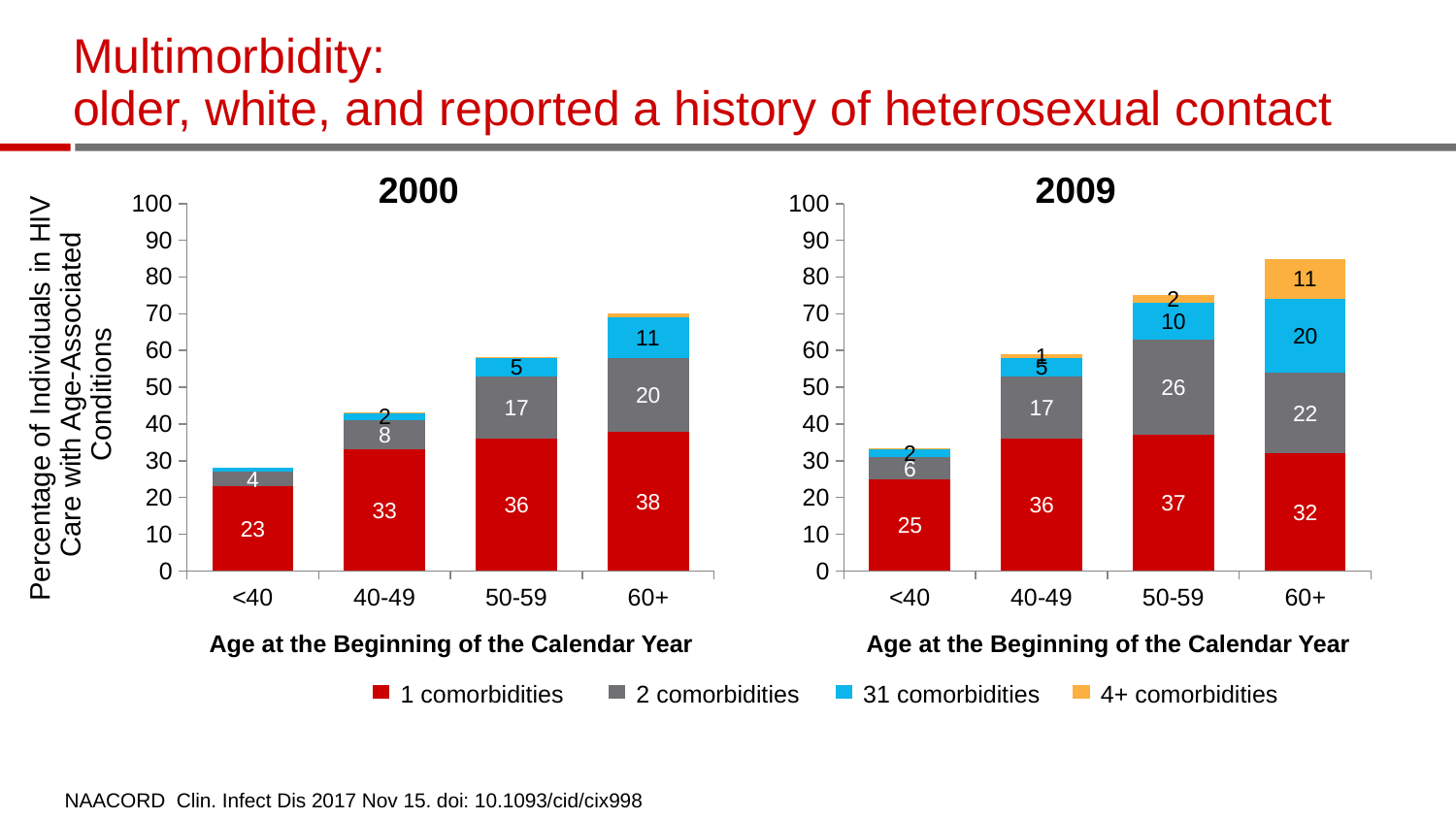
In the 2009 chart, what is the difference between the 2 comorbidities values for the 50-59 and 40-49 age groups? 9 In the 2009 chart, is the total height of the <40 bar greater or less than 30? greater In the 2000 chart, which age group has the highest value for 1 comorbidities? 60+ What kind of chart is the 2009 chart? Stacked bar chart In the 2009 chart, what is the value for 4+ comorbidities in the 60+ age group? 11 How many series does the legend list? 4 For the 60+ age group, is the 1 comorbidities value larger in the 2000 chart or the 2009 chart? 2000 How many age groups are shown on the x axis of the 2000 chart? 4 In the 2009 chart, which age group has the lowest value for 1 comorbidities? <40 In the 2009 chart, what is the value for 2 comorbidities in the 50-59 age group? 26 In the 2009 chart, what is the total height of the stacked bar for the 60+ age group? 85 In the 2000 chart, what is the value for 1 comorbidities in the 60+ age group? 38